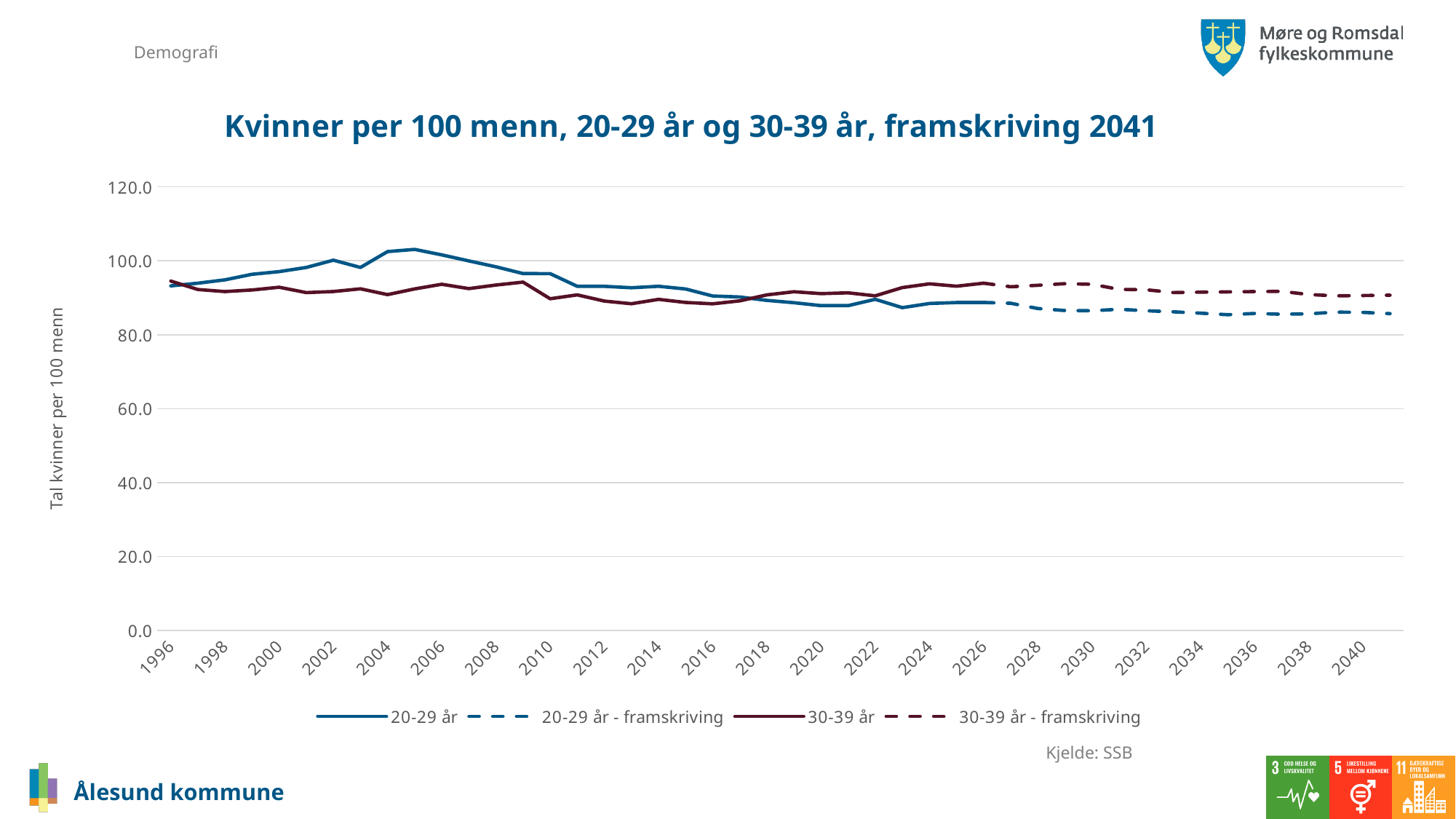
Is the value for 20-29 år in 2005 greater or less than 100? greater In 2024, which series has the higher value, 20-29 år or 30-39 år? 30-39 år What kind of chart is shown on the slide? line chart How many series does the legend list? 4 What is the title of the chart? Kvinner per 100 menn, 20-29 år og 30-39 år, framskriving 2041 Is the value for 20-29 år - framskriving in 2040 greater or less than 80? greater In 2040, which projection is higher, 20-29 år - framskriving or 30-39 år - framskriving? 30-39 år - framskriving In 2004, which series has the higher value, 20-29 år or 30-39 år? 20-29 år Which series reaches the highest value anywhere on the chart? 20-29 år Is the value for 30-39 år in 2010 greater or less than 100? less What is the label on the vertical axis? Tal kvinner per 100 menn Does the 20-29 år line rise or fall between 2005 and 2026? fall